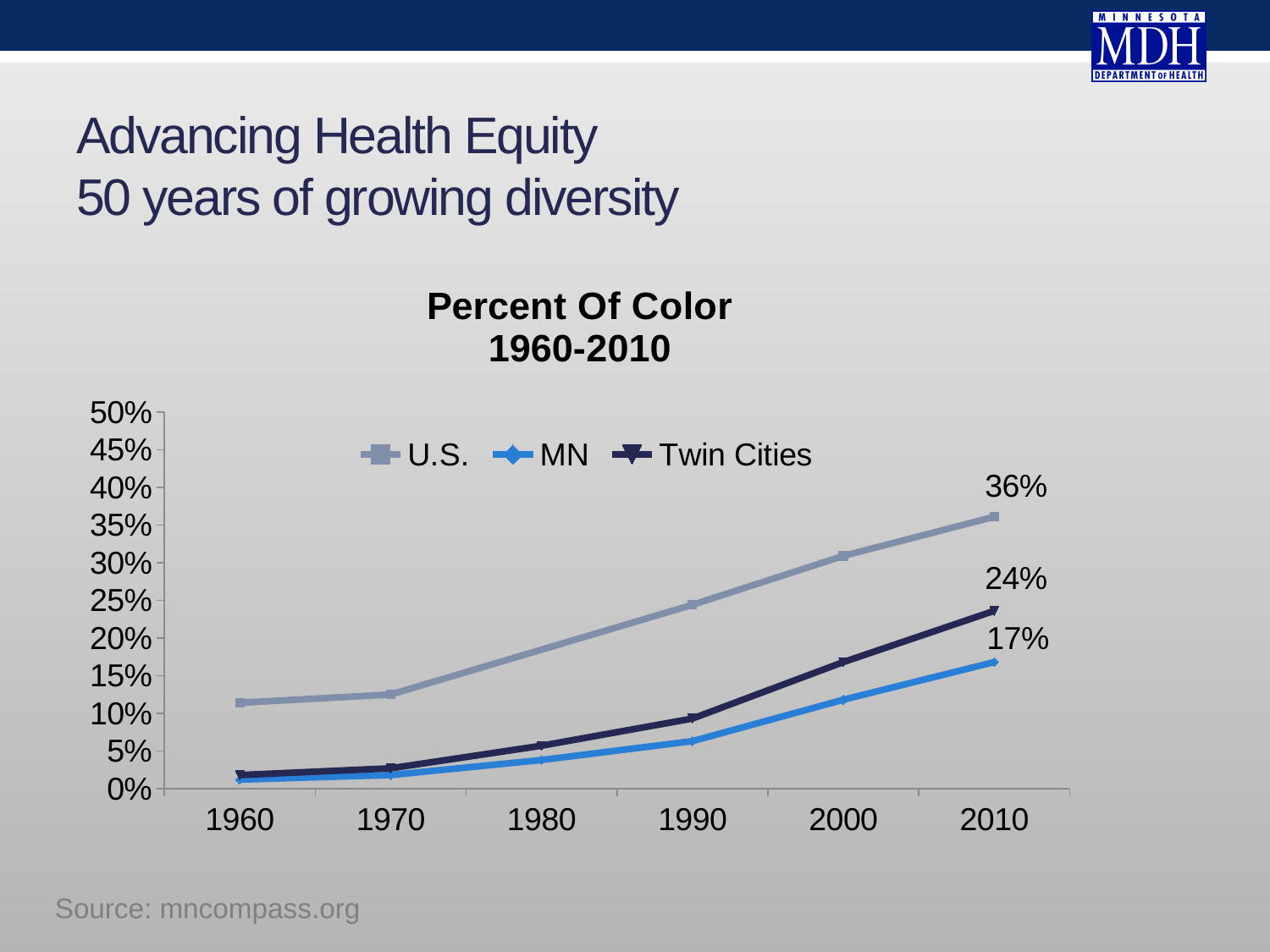
How many series does the legend list? 3 What is the value for U.S. in 2010? 36% What is the difference between the U.S. and MN values in 2010? 19% What kind of chart is shown? line chart What is the difference between the Twin Cities and MN values in 2010? 7% What is the value for MN in 2010? 17% Is the value for U.S. in 1960 greater or less than 5%? greater Is the value for MN in 1990 greater or less than 10%? less Which series has the highest value in 2010? U.S. Which is larger in 2010, the Twin Cities value or the MN value? Twin Cities Which series has the lowest value in 2010? MN What is the value for Twin Cities in 2010? 24%